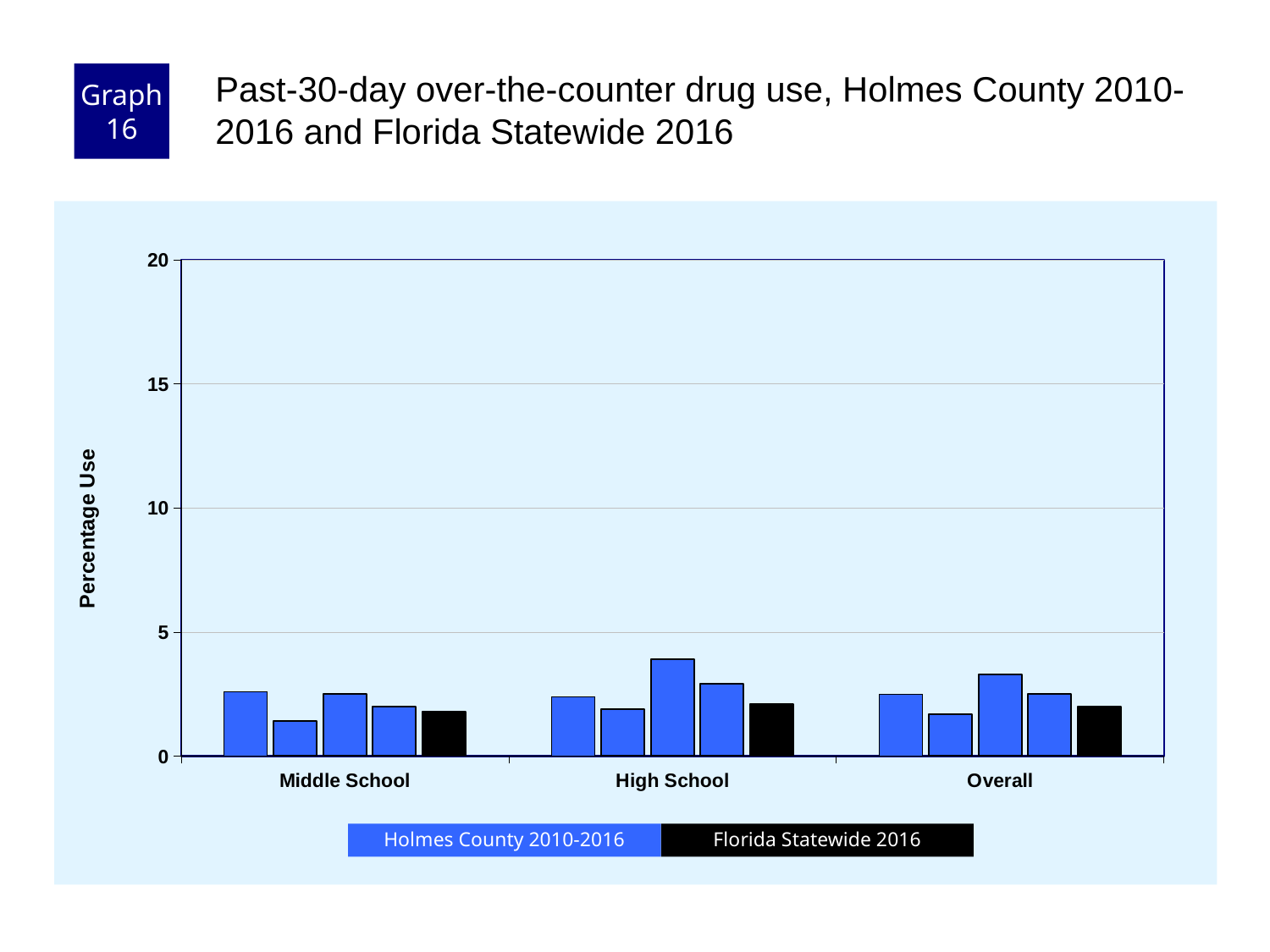
How many categories are shown on the x axis? 3 What is the highest value shown on the y axis? 20 What is the title of the chart? Past-30-day over-the-counter drug use, Holmes County 2010-2016 and Florida Statewide 2016 What is the label on the y axis? Percentage Use Which category contains the tallest bar on the chart? High School What kind of chart is shown on the slide? bar chart How many series does the legend list? 2 Is the Florida Statewide 2016 value for Overall greater or less than 5? less Is the Florida Statewide 2016 value for Middle School greater or less than 5? less Is the Florida Statewide 2016 value for High School greater or less than 5? less